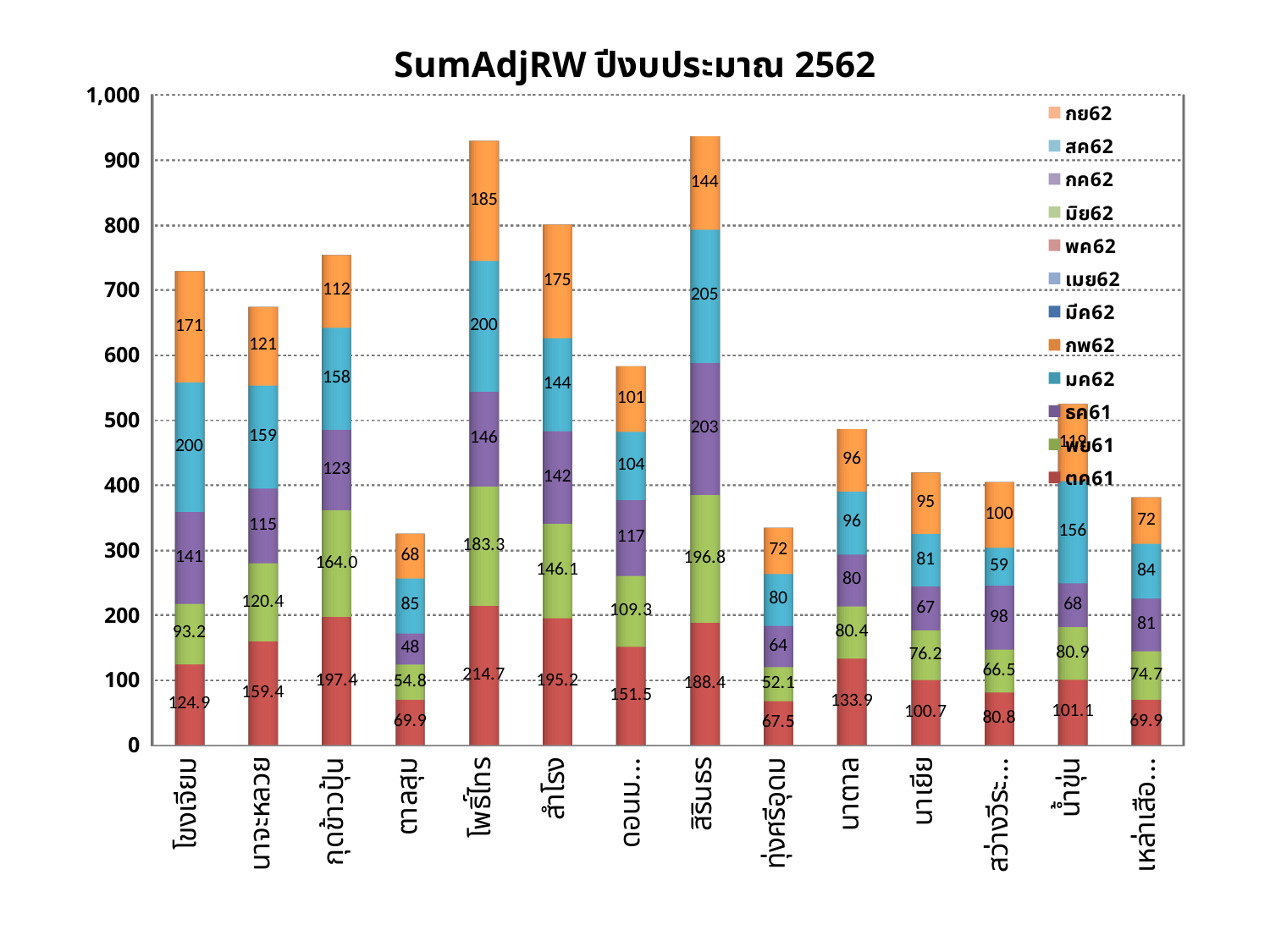
What is the total of the stacked bar for ตาลสุม? 325.7 What is the กพ62 value for โขงเจียม? 171 What is the มค62 value for สิรินธร? 205 What is the title of the chart? SumAdjRW ปีงบประมาณ 2562 What is the ตค61 value for โพธิ์ไตร? 214.7 What is the difference between the กพ62 values for โพธิ์ไตร and สำโรง? 10 How many series does the legend list? 12 Which category has the highest ตค61 value? โพธิ์ไตร What is the พย61 value for นาจะหลวย? 120.4 What kind of chart is shown on the slide? Stacked bar chart How many categories (bars) are shown along the x axis? 14 Which has the larger ตค61 value, กุดข้าวปุ้น or สำโรง? กุดข้าวปุ้น